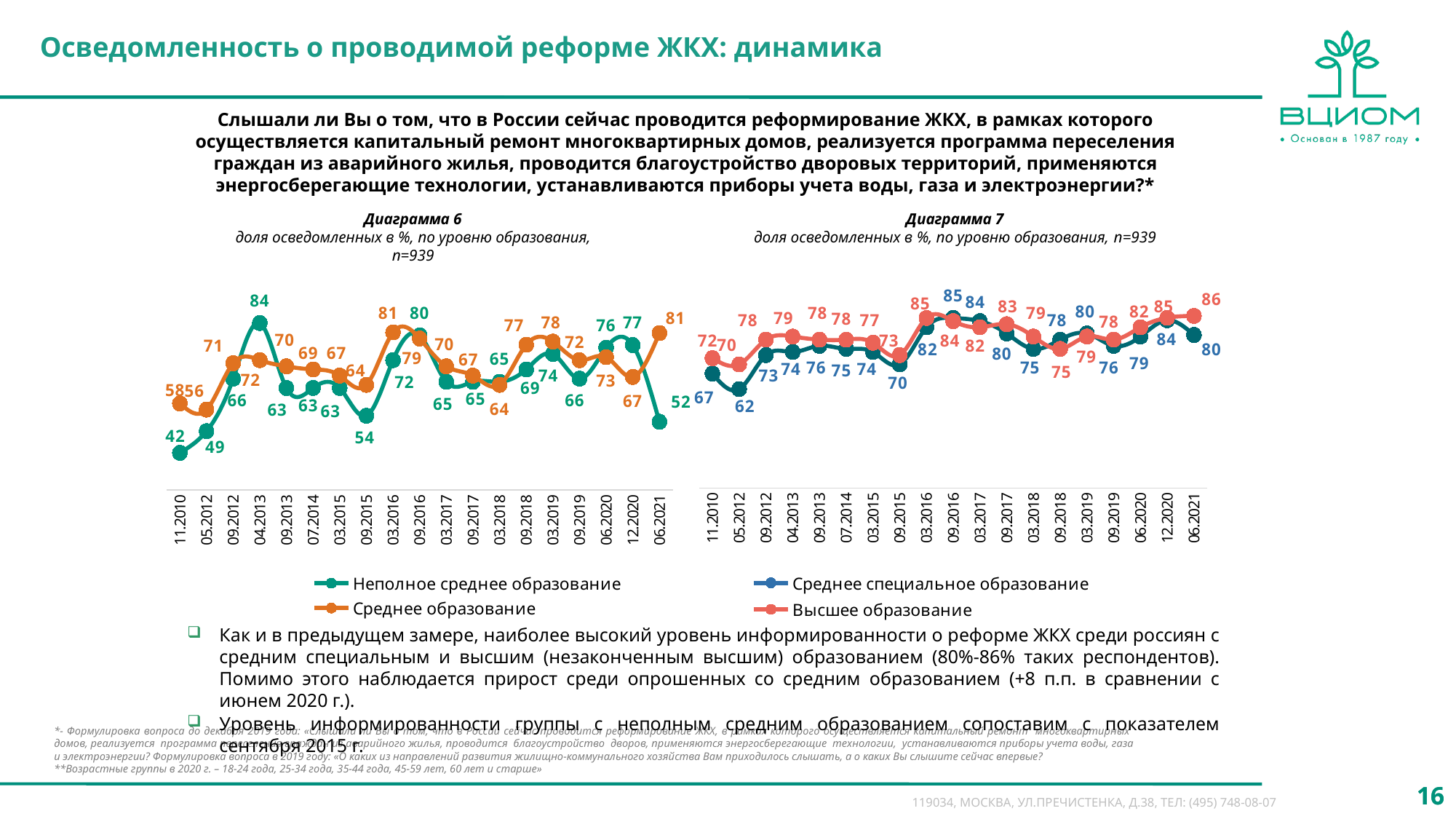
On Диаграмма 7 (right chart), what is the difference between Высшее образование and Среднее специальное образование at 11.2010? 5 How many dates are shown on the x axis of Диаграмма 7 (right chart)? 19 On Диаграмма 6 (left chart), what is the value for Неполное среднее образование at 04.2013? 84 How many series does the legend of Диаграмма 6 (left chart) list? 2 On Диаграмма 7 (right chart), what is the value for Среднее специальное образование at 05.2012? 62 On Диаграмма 7 (right chart), at which date is the Высшее образование series highest? 06.2021 On Диаграмма 6 (left chart), what is the difference between Среднее образование and Неполное среднее образование at 06.2021? 29 On Диаграмма 6 (left chart), at which date is the Неполное среднее образование series lowest? 11.2010 What type of chart is Диаграмма 6 (left chart)? Line chart On Диаграмма 6 (left chart), which series has the higher value at 12.2020: Неполное среднее образование or Среднее образование? Неполное среднее образование On Диаграмма 6 (left chart), what is the value for Среднее образование at 06.2021? 81 On Диаграмма 7 (right chart), what is the value for Высшее образование at 06.2021? 86